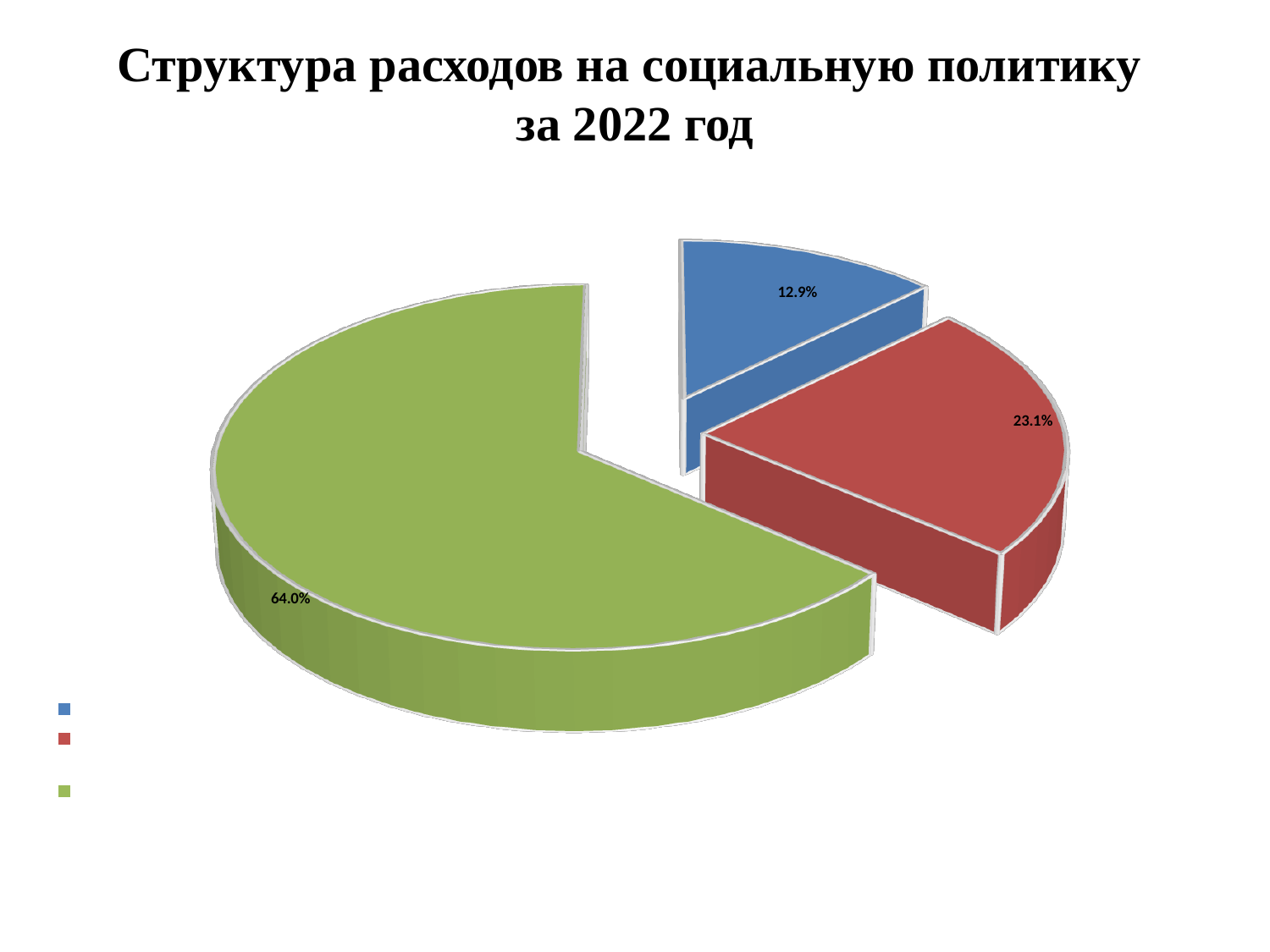
Which is larger, the red slice or the blue slice? the red slice What percentage is shown on the blue slice? 12.9% Which slice is the largest? the green slice (64.0%) How many slices does the pie chart have? 3 What is the title of the chart? Структура расходов на социальную политику за 2022 год What percentage is shown on the green slice? 64.0% What percentage is shown on the red slice? 23.1% What kind of chart is shown on the slide? pie chart How many entries does the legend list? 3 What is the difference in percentage points between the red slice and the blue slice? 10.2 What is the difference in percentage points between the green slice and the red slice? 40.9 Which slice is the smallest? the blue slice (12.9%)